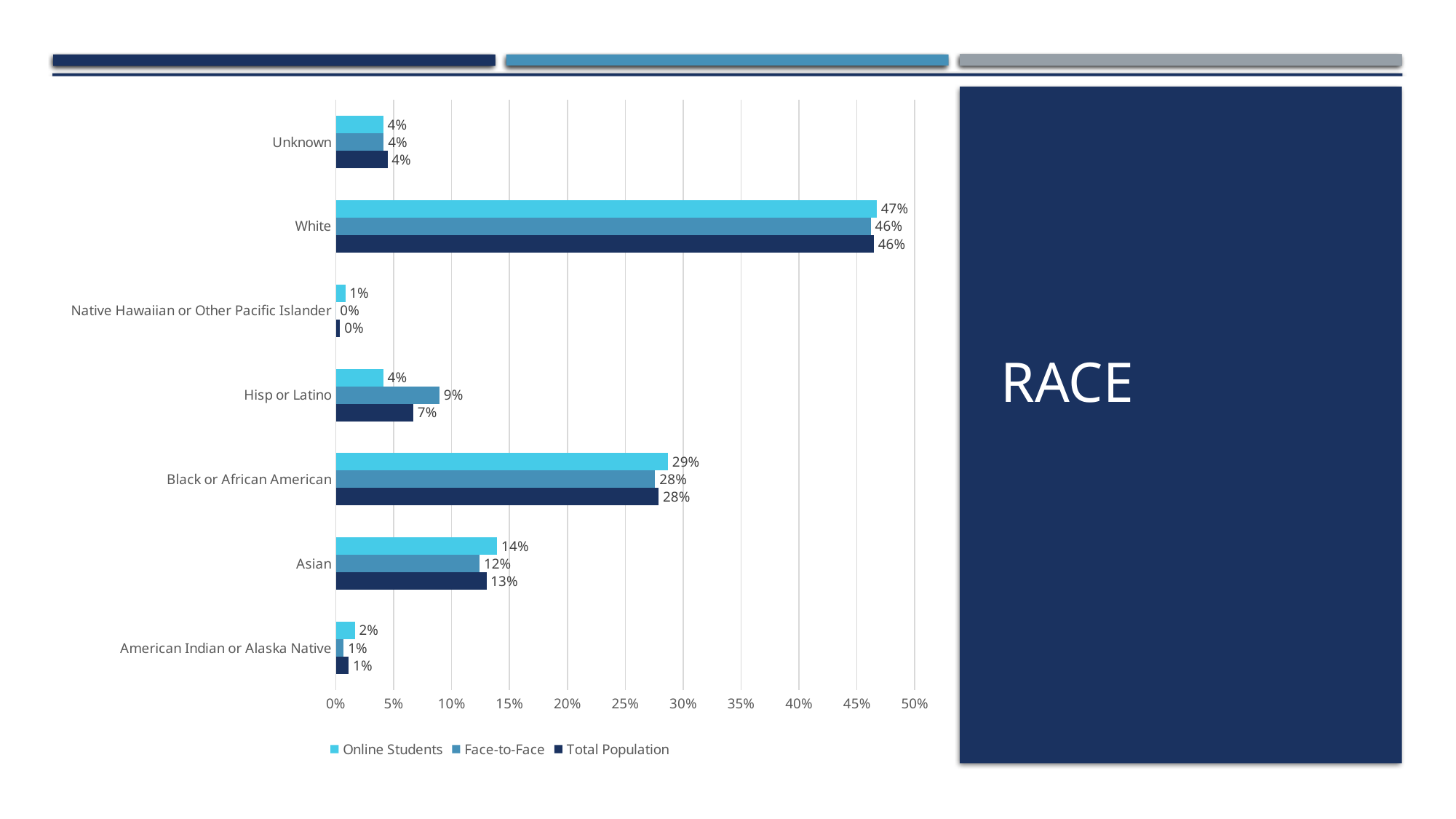
What is the title shown in the panel to the right of the chart? RACE How many race categories are shown on the chart? 7 What kind of chart is shown on the slide? Bar chart Which is larger for Asian: the Online Students value or the Face-to-Face value? Online Students What is the Online Students value for White? 47% What is the Face-to-Face value for Hisp or Latino? 9% What is the Total Population value for Asian? 13% How many series does the legend list? 3 Which category has the highest Online Students value? White What is the difference between the Face-to-Face and Online Students values for Hisp or Latino? 5% What is the Online Students value for Black or African American? 29% Which category has the lowest Face-to-Face value? Native Hawaiian or Other Pacific Islander